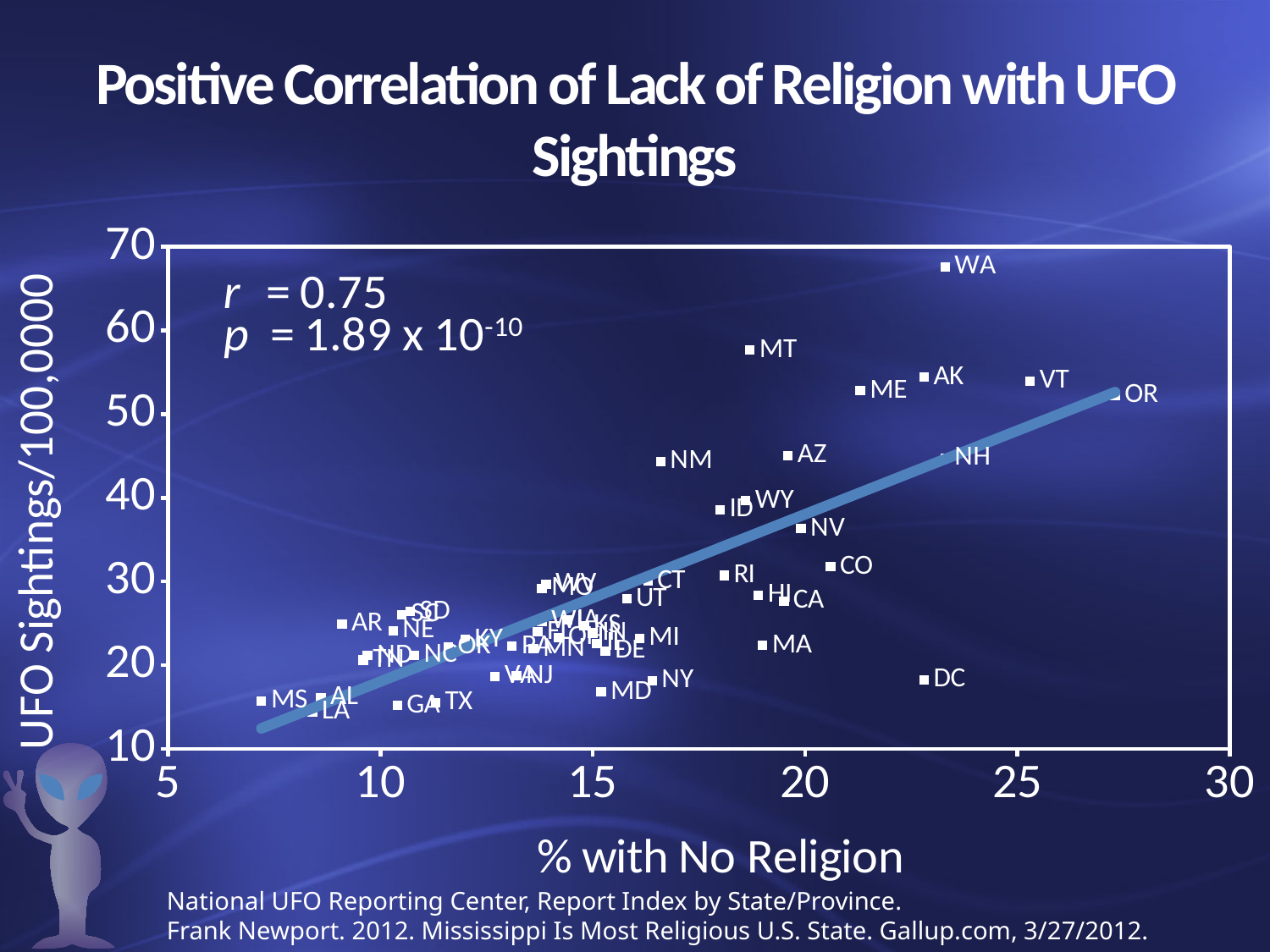
Is the % with No Religion for OR greater or less than 25? greater Which state has the highest UFO sightings per 100,000 on the chart? WA Is the UFO sightings value for MT greater or less than 50? greater Which has more UFO sightings per 100,000, WA or MT? WA What is the p value shown on the chart? 1.89 x 10^-10 Do UFO sightings generally rise or fall as % with No Religion increases along the x axis? rise Which state has the highest % with No Religion on the chart? OR Which state has the lowest % with No Religion on the chart? MS What kind of chart is shown on the slide? scatter chart Is the UFO sightings value for DC greater or less than 20? less What is the correlation coefficient r shown on the chart? 0.75